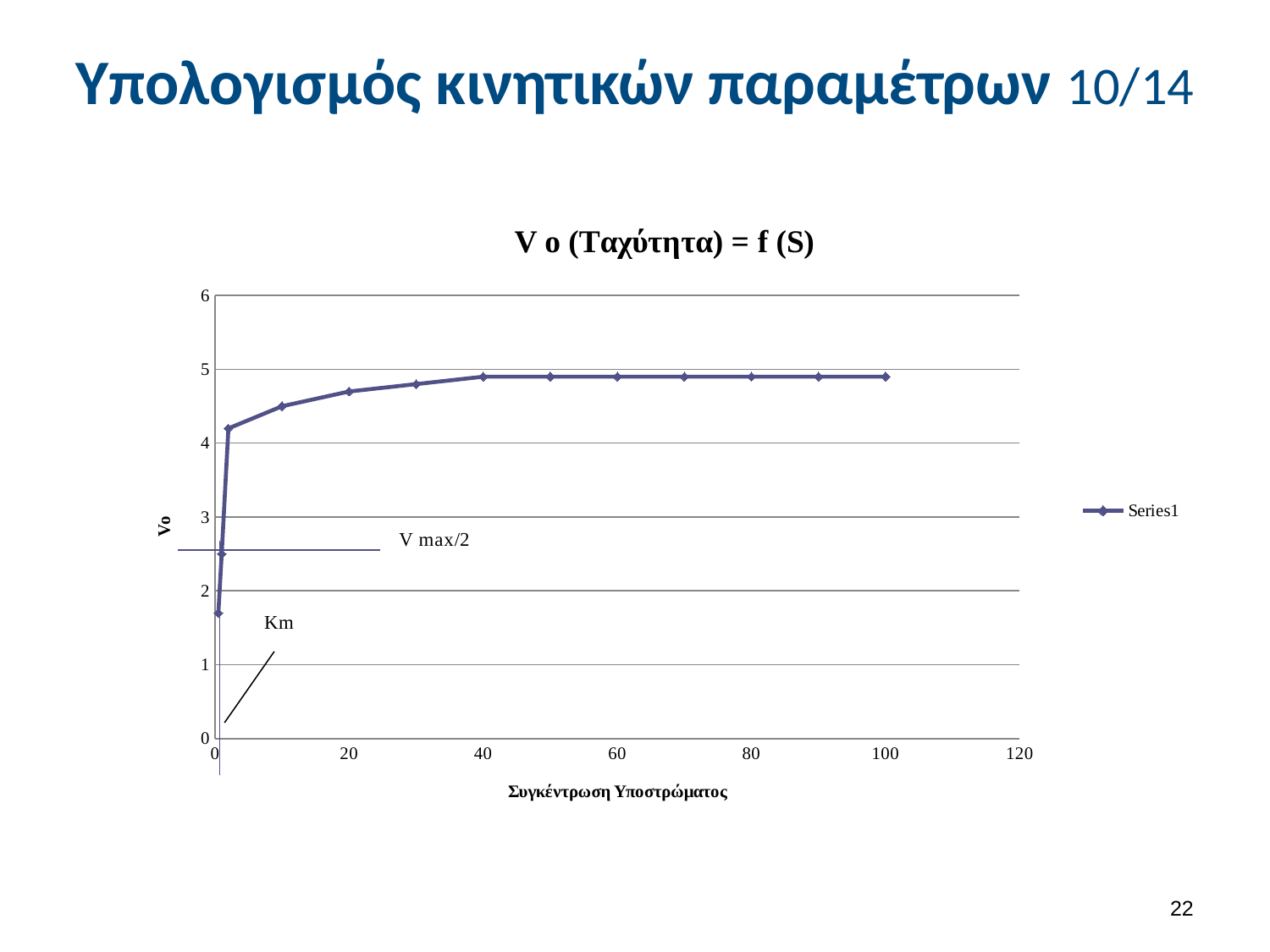
Which has the larger Vo value: substrate concentration 10 or substrate concentration 40? 40 Is the value of Vo at a substrate concentration of 20 greater or less than 4? greater Is the value of Vo at a substrate concentration of 100 greater or less than 4? greater Do the Vo values rise or fall as substrate concentration increases along the x axis? rise How many series does the legend list? 1 Is the value of Vo at a substrate concentration of 10 greater or less than 5? less What kind of chart is shown on the slide? line chart What is the name of the series shown in the legend? Series1 What is the title of the chart? V o (Ταχύτητα) = f (S)